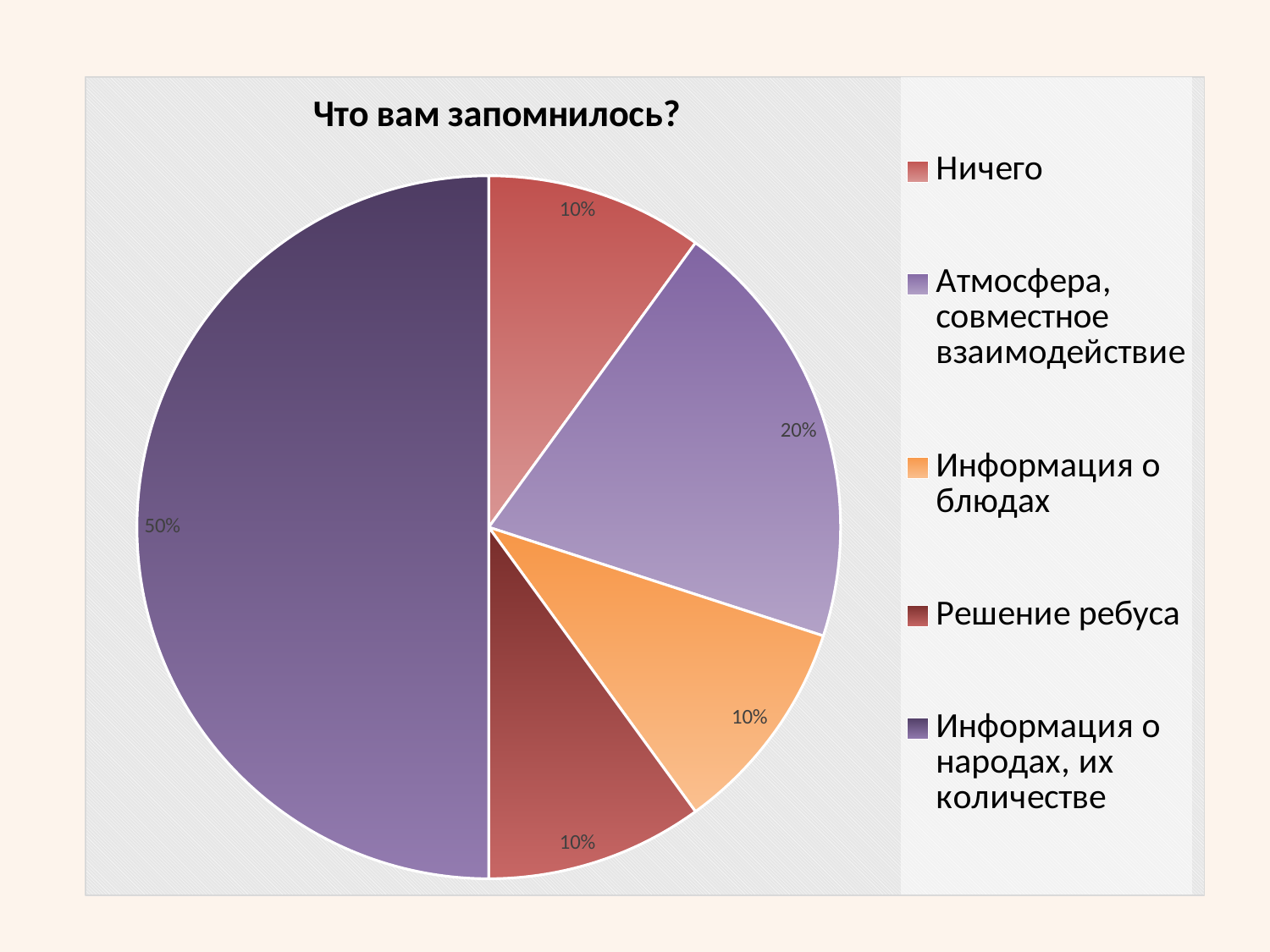
What is the title of the chart? Что вам запомнилось? What is the value shown for "Ничего"? 10% What is the value shown for "Информация о блюдах"? 10% What share of the pie does "Атмосфера, совместное взаимодействие" take? 20% What share of the pie does "Информация о народах, их количестве" take? 50% Which legend entry is shown in orange? Информация о блюдах What kind of chart is shown on the slide? pie chart What is the difference between the shares of "Информация о народах, их количестве" and "Атмосфера, совместное взаимодействие"? 30% Which category has the largest slice of the pie? Информация о народах, их количестве How many categories does the legend list? 5 What is the value shown for "Решение ребуса"? 10% Which is larger, the share for "Атмосфера, совместное взаимодействие" or the share for "Ничего"? Атмосфера, совместное взаимодействие